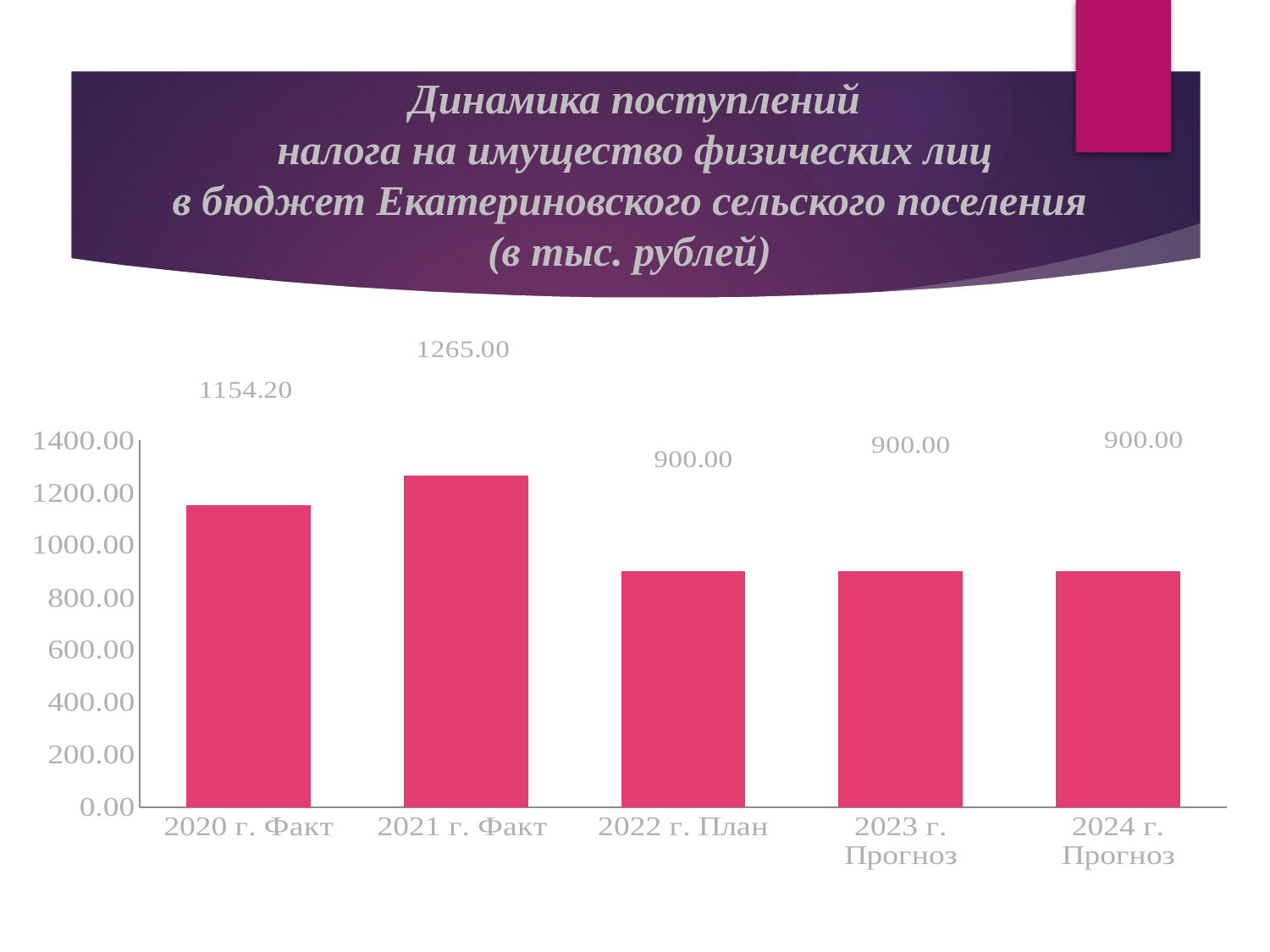
What is the difference between the values for 2020 г. Факт and 2022 г. План? 254.20 Do the values rise or fall from 2021 г. Факт to 2022 г. План? fall What kind of chart is shown on the slide? bar chart What is the value for 2021 г. Факт? 1265.00 How many categories are shown on the x axis? 5 What is the value for 2022 г. План? 900.00 What is the value for 2020 г. Факт? 1154.20 Which is larger, the value for 2020 г. Факт or the value for 2023 г. Прогноз? 2020 г. Факт What is the difference between the values for 2021 г. Факт and 2020 г. Факт? 110.80 Is the value for 2021 г. Факт greater or less than 1200.00? greater Is the value for 2024 г. Прогноз greater or less than 1000.00? less Which category has the highest value? 2021 г. Факт